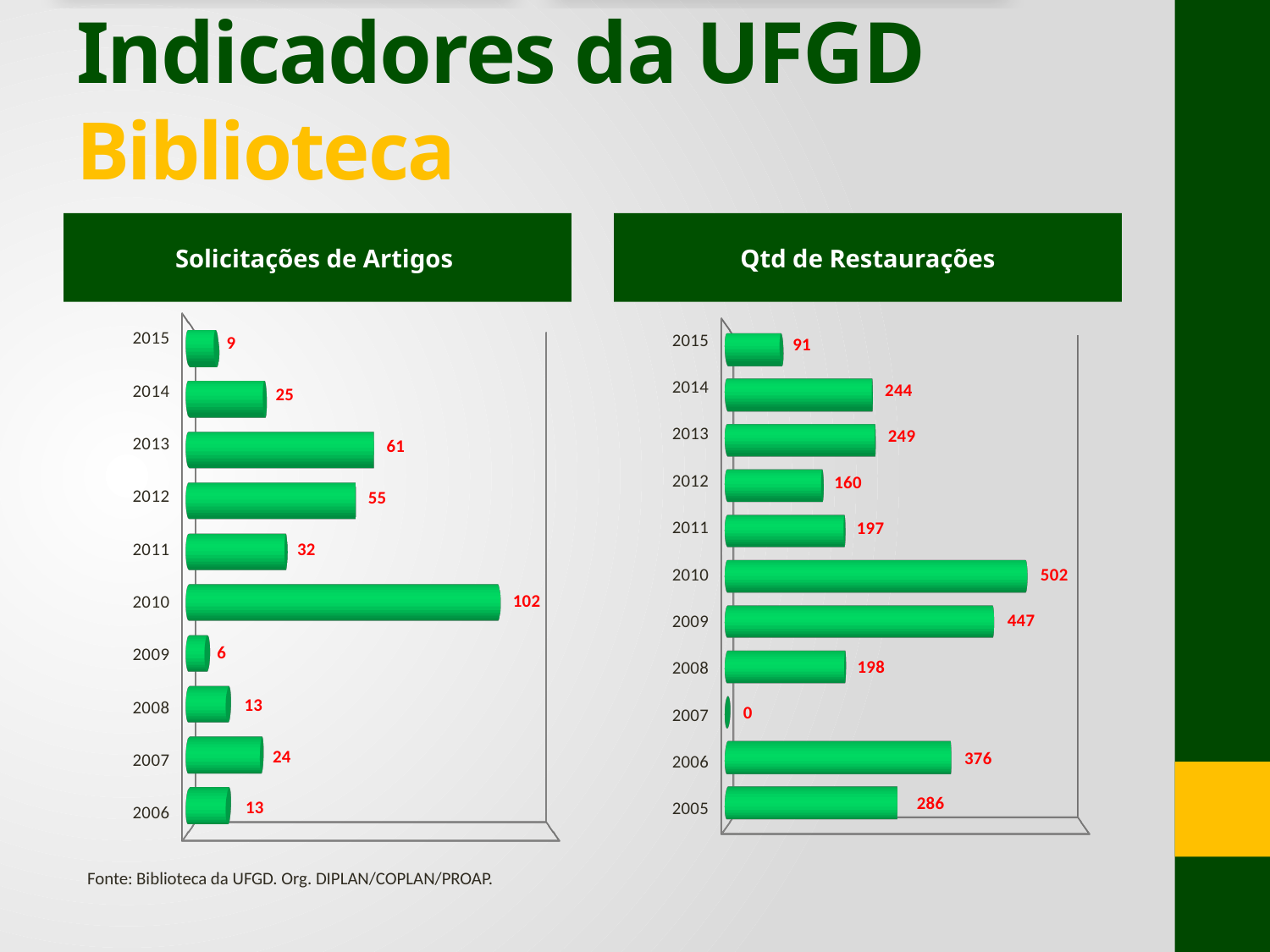
In the 'Solicitações de Artigos' chart, which year has the lowest value? 2009 In the 'Qtd de Restaurações' chart, what is the value for 2015? 91 In the 'Solicitações de Artigos' chart, which is larger, the value for 2014 or the value for 2007? 2014 In the 'Qtd de Restaurações' chart, how many years are shown? 11 In the 'Qtd de Restaurações' chart, which year has the highest value? 2010 In the 'Solicitações de Artigos' chart, how many years are shown? 10 In the 'Qtd de Restaurações' chart, what is the value for 2009? 447 In the 'Qtd de Restaurações' chart, what is the difference between the values for 2010 and 2009? 55 What kind of chart is the 'Qtd de Restaurações' chart? Bar chart In the 'Qtd de Restaurações' chart, which year has the lowest value? 2007 In the 'Solicitações de Artigos' chart, what is the value for 2010? 102 In the 'Solicitações de Artigos' chart, what is the difference between the values for 2013 and 2012? 6